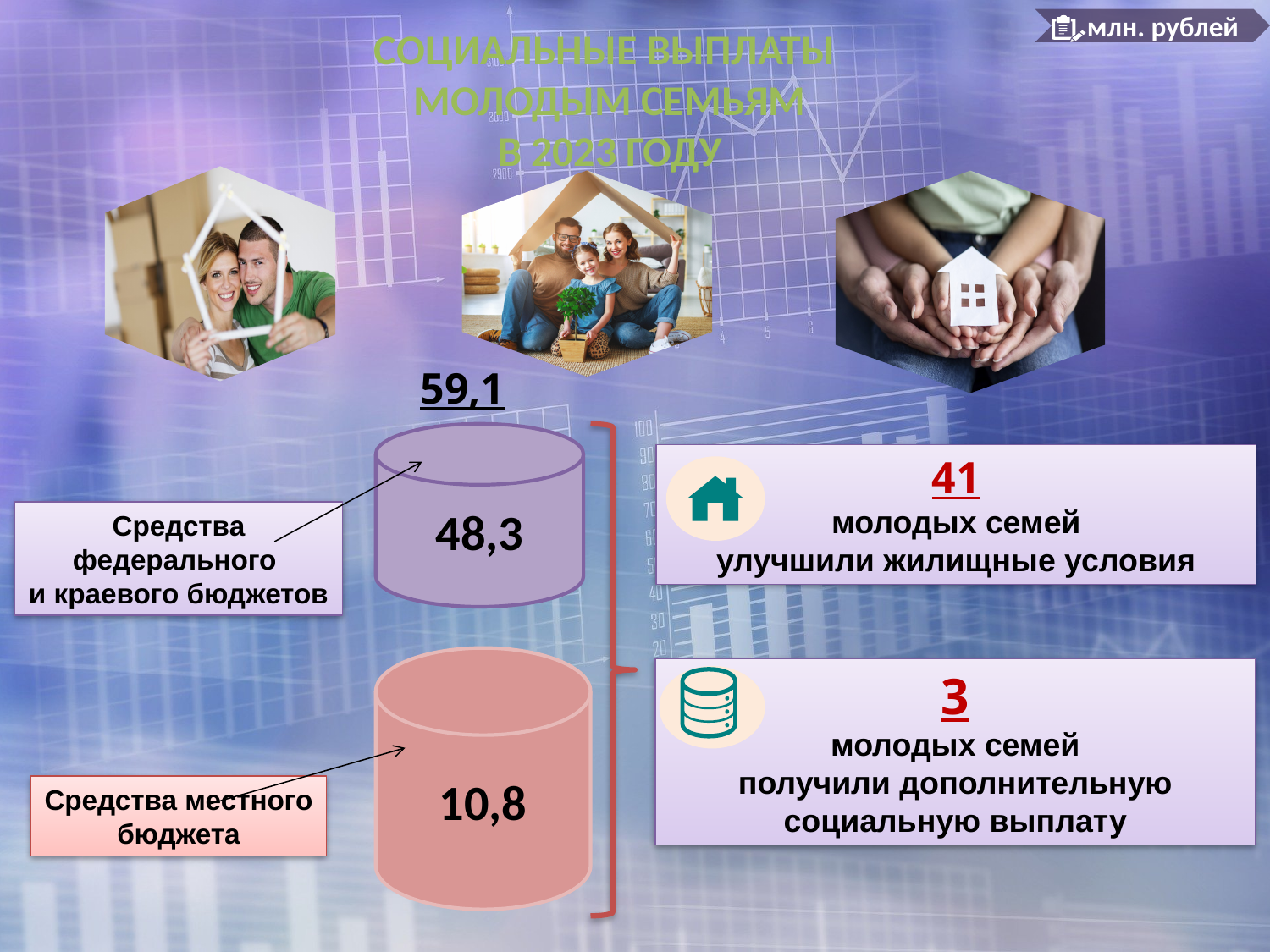
How many young families improved their housing conditions according to the slide? 41 What colour is the cylinder representing the local budget funds? Pink (red) How many funding sources (cylinders) are shown on the slide? 2 In what units are the values on the slide expressed, according to the label in the top right corner? млн. рублей What is the difference between the federal/regional budget funds and the local budget funds? 37,5 Which funding source has the smallest value? Средства местного бюджета Is the value for the federal and regional budget funds greater or less than 40? greater What is the value shown for the federal and regional budget funds (Средства федерального и краевого бюджетов)? 48,3 What is the value shown for the local budget funds (Средства местного бюджета)? 10,8 How many young families received an additional social payment according to the slide? 3 What total is shown above the two cylinders? 59,1 Which funding source is larger: federal and regional budgets or the local budget? Federal and regional budgets